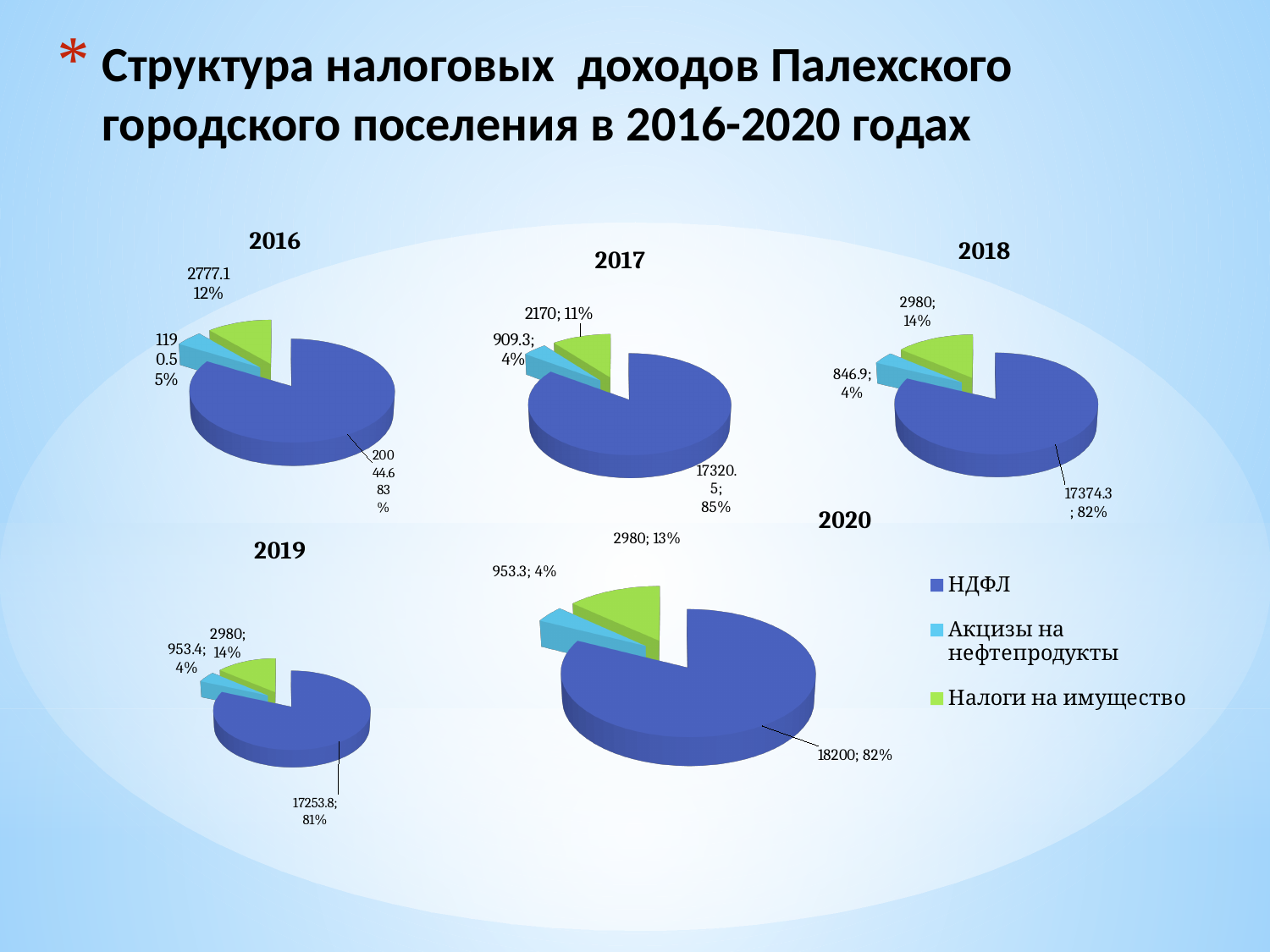
In the 2017 pie chart, which category has the smallest slice? Акцизы на нефтепродукты How many series does the legend list? 3 In the 2020 pie chart, which category has the largest slice? НДФЛ In the 2017 pie chart, what is the value and share for НДФЛ? 17320.5; 85% What kind of charts are shown on the slide? Pie charts In the 2020 pie chart, what share does Налоги на имущество have? 13% In the 2016 pie chart, what share does Налоги на имущество have? 12% In the 2020 pie chart, what is the difference between the НДФЛ value and the Налоги на имущество value? 15220 In the 2019 pie chart, what is the value for НДФЛ? 17253.8 Which colour represents Налоги на имущество in the legend? Green How many pie charts are on the slide? 5 In the 2018 pie chart, what is the value for Акцизы на нефтепродукты? 846.9